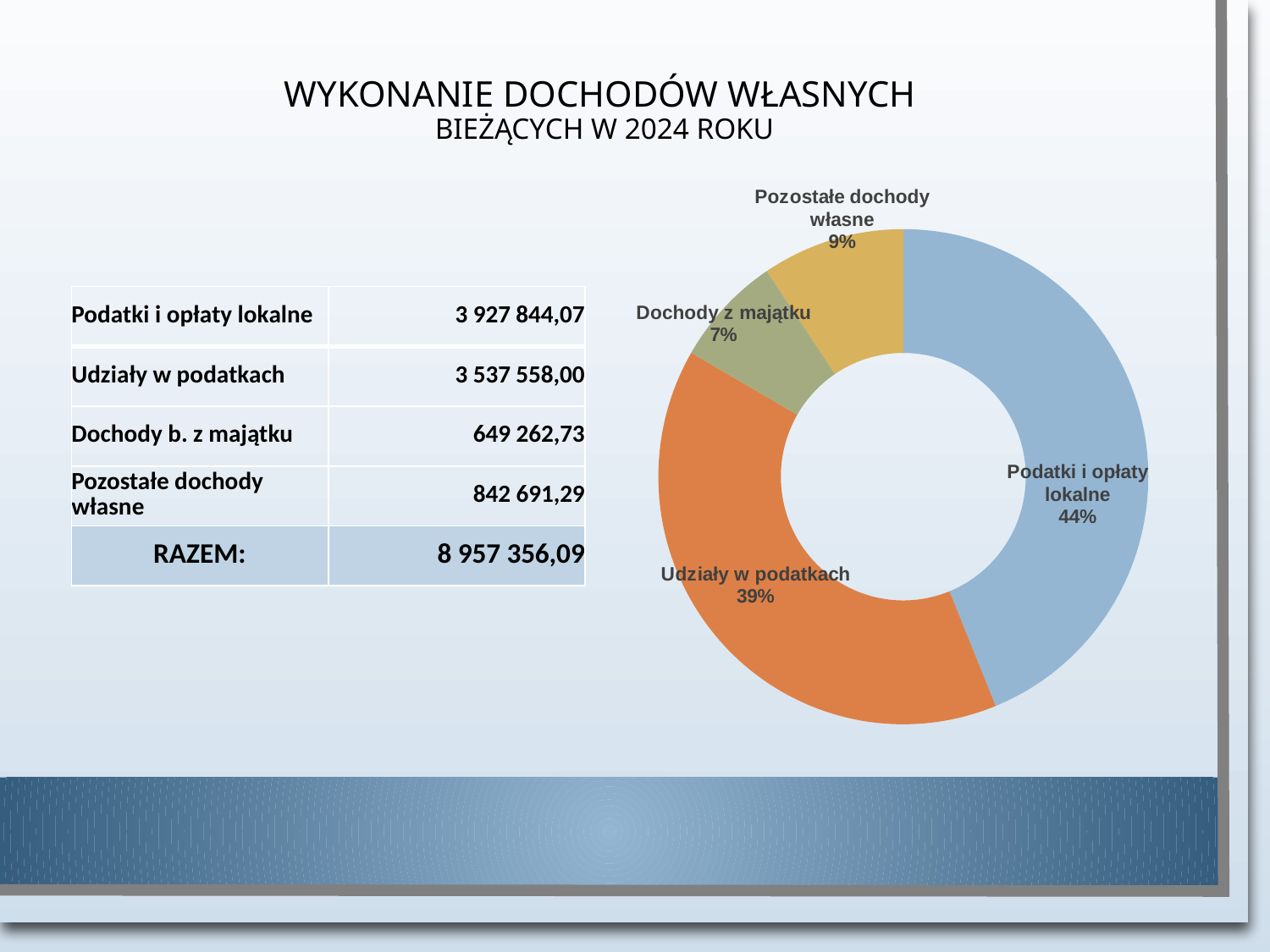
What share of the doughnut chart does 'Dochody z majątku' represent? 7% What is the title shown above the chart on the slide? WYKONANIE DOCHODÓW WŁASNYCH BIEŻĄCYCH W 2024 ROKU What colour is the 'Udziały w podatkach' slice in the doughnut chart? orange What kind of chart is shown on the slide? doughnut chart What share of the doughnut chart does 'Podatki i opłaty lokalne' represent? 44% Which slice is larger: 'Pozostałe dochody własne' or 'Dochody z majątku'? Pozostałe dochody własne What share of the doughnut chart does 'Pozostałe dochody własne' represent? 9% How many slices does the doughnut chart have? 4 Which slice of the doughnut chart is the largest? Podatki i opłaty lokalne Which slice of the doughnut chart is the smallest? Dochody z majątku What is the difference in percentage points between the 'Podatki i opłaty lokalne' and 'Udziały w podatkach' slices? 5 percentage points